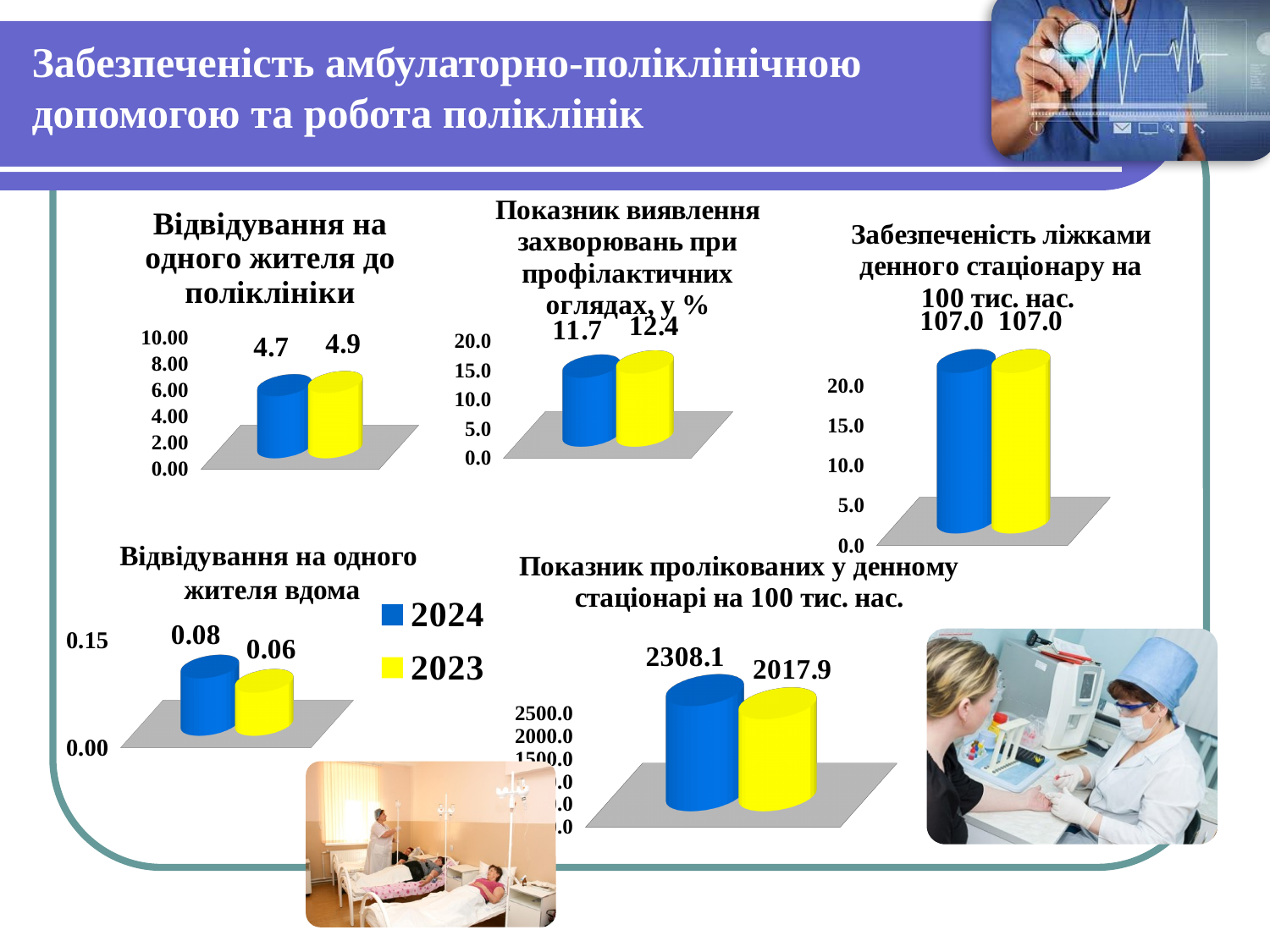
How many series does the shared legend on the slide list? 2 In the chart 'Показник пролікованих у денному стаціонарі на 100 тис. нас.', is the value for 2023 greater or less than 2500.0? less In the chart 'Показник пролікованих у денному стаціонарі на 100 тис. нас.', what is the difference between the 2024 and 2023 values? 290.2 In the chart 'Відвідування на одного жителя до поліклініки', what is the value for 2023? 4.9 In the chart 'Забезпеченість ліжками денного стаціонару на 100 тис. нас.', what is the value for 2024? 107.0 In the chart 'Відвідування на одного жителя вдома', which year has the higher value, 2024 or 2023? 2024 What type of chart is 'Відвідування на одного жителя до поліклініки'? bar chart In the chart 'Відвідування на одного жителя вдома', what is the value for 2023? 0.06 In the chart 'Показник виявлення захворювань при профілактичних оглядах, у %', what is the value for 2023? 12.4 In the chart 'Показник пролікованих у денному стаціонарі на 100 тис. нас.', what is the value for 2024? 2308.1 In the chart 'Відвідування на одного жителя до поліклініки', what is the value for 2024? 4.7 In the chart 'Показник виявлення захворювань при профілактичних оглядах, у %', what is the difference between the 2023 and 2024 values? 0.7